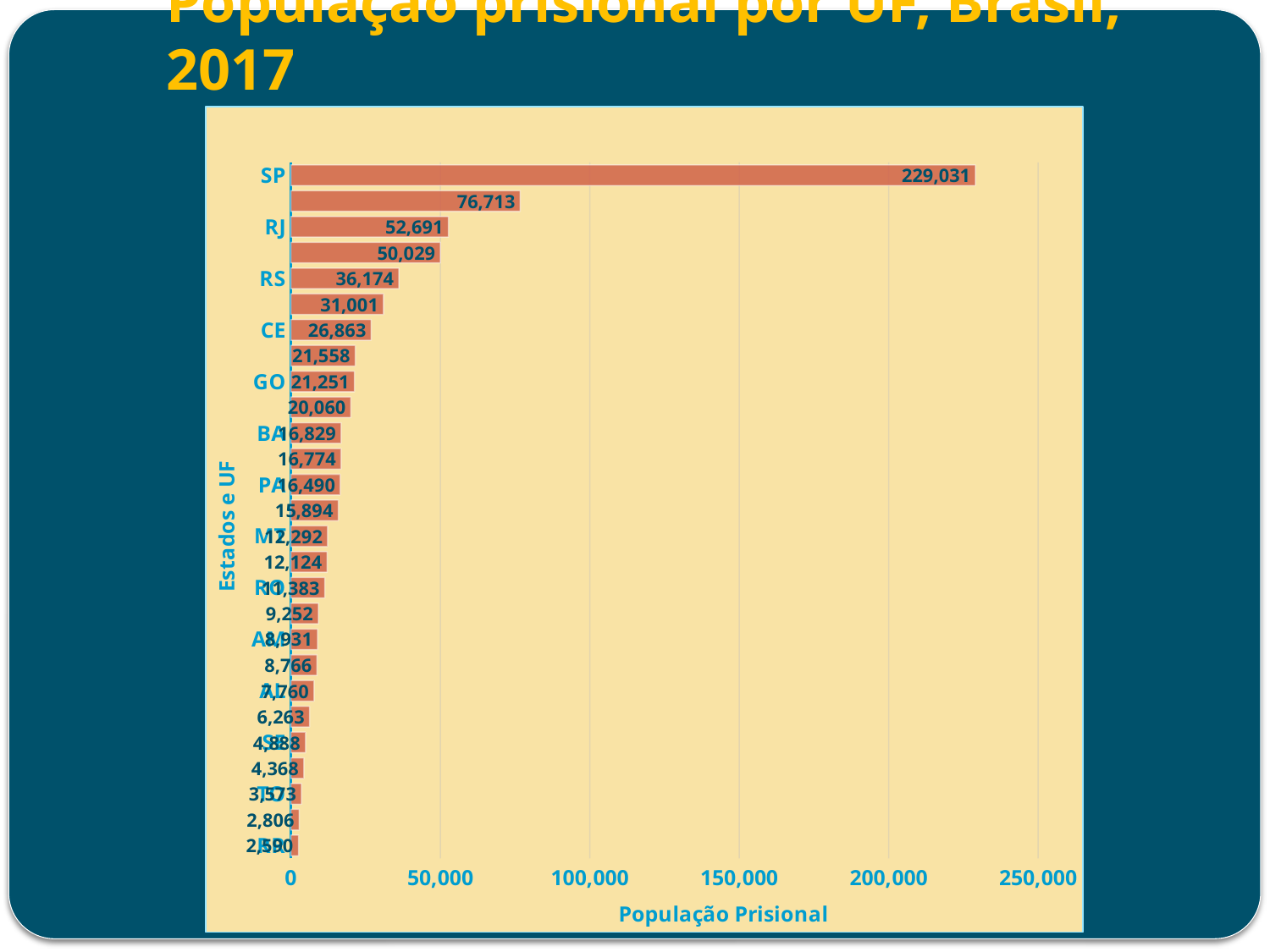
What is the prison population value shown for GO? 21,251 Which state (UF) has the highest prison population in the chart? SP What is the prison population value shown for CE? 26,863 What is the prison population value shown for BA? 16,829 What is the difference between the prison population of SP and that of RJ? 176,340 What is the prison population value shown for RS? 36,174 What is the prison population value shown for RJ? 52,691 What kind of chart is shown on the slide? Bar chart Is the value for SP greater or less than 200,000? greater Which has a larger prison population, RS or CE? RS How many bars (states/UFs) are plotted in the chart? 27 What is the prison population value shown for SP? 229,031